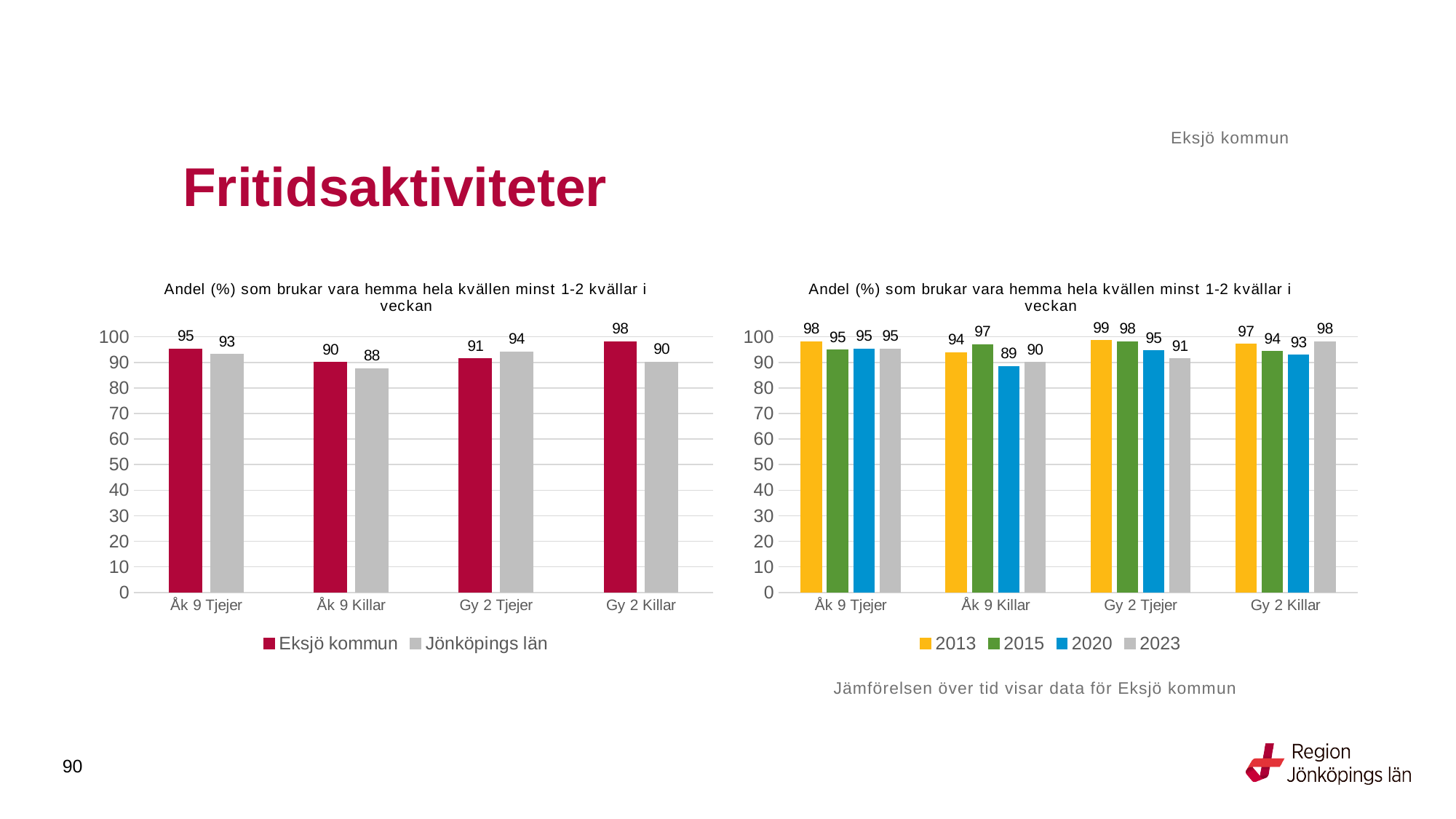
In the left chart, what is the difference between Eksjö kommun and Jönköpings län for Gy 2 Killar? 8 In the left chart, which category has the highest value for Eksjö kommun? Gy 2 Killar In the right chart, what is the value for 2020 for Åk 9 Killar? 89 In the right chart, what is the value for 2013 for Gy 2 Tjejer? 99 In the right chart, which year has the highest value for Gy 2 Killar? 2023 In the right chart, is the value for 2015 or 2023 larger for Gy 2 Tjejer? 2015 What kind of chart is the right chart? Bar chart In the left chart, what is the value for Jönköpings län for Gy 2 Tjejer? 94 In the left chart, what is the value for Eksjö kommun for Åk 9 Killar? 90 In the left chart, which category has the lowest value for Jönköpings län? Åk 9 Killar In the left chart, how many series does the legend list? 2 In the right chart, how many series does the legend list? 4